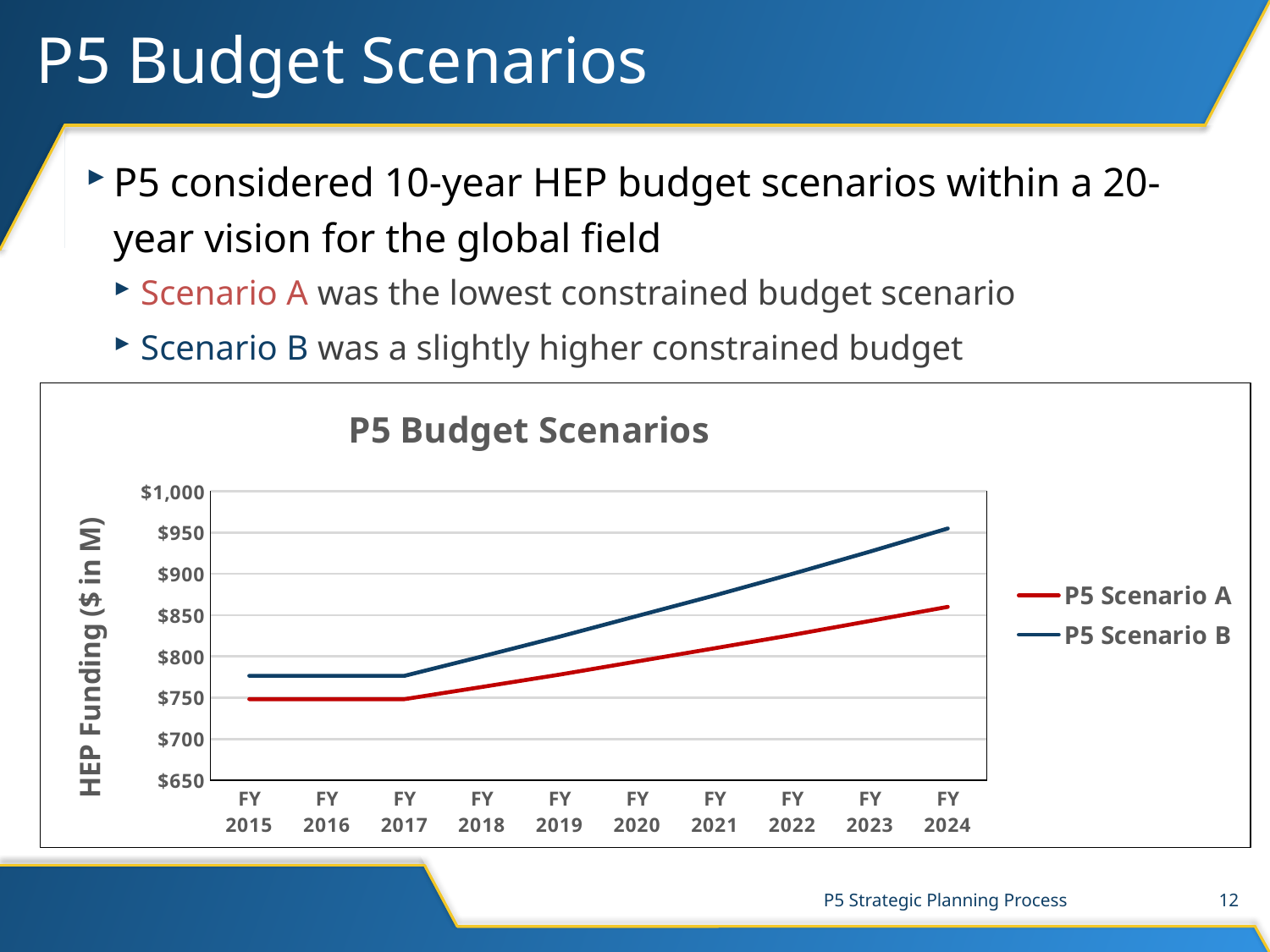
Is the value for P5 Scenario B in FY 2015 greater or less than $750? greater What kind of chart is shown on the slide? line chart How many fiscal years are plotted along the x axis? 10 How many series does the legend list? 2 Is the value for P5 Scenario A in FY 2015 greater or less than $800? less In FY 2024, which series has the higher value, P5 Scenario A or P5 Scenario B? P5 Scenario B Is the value for P5 Scenario B in FY 2024 greater or less than $900? greater What is the label on the vertical axis of the chart? HEP Funding ($ in M) In which fiscal year does P5 Scenario B reach its highest value? FY 2024 Do the values for P5 Scenario A rise or fall from FY 2017 to FY 2024? rise